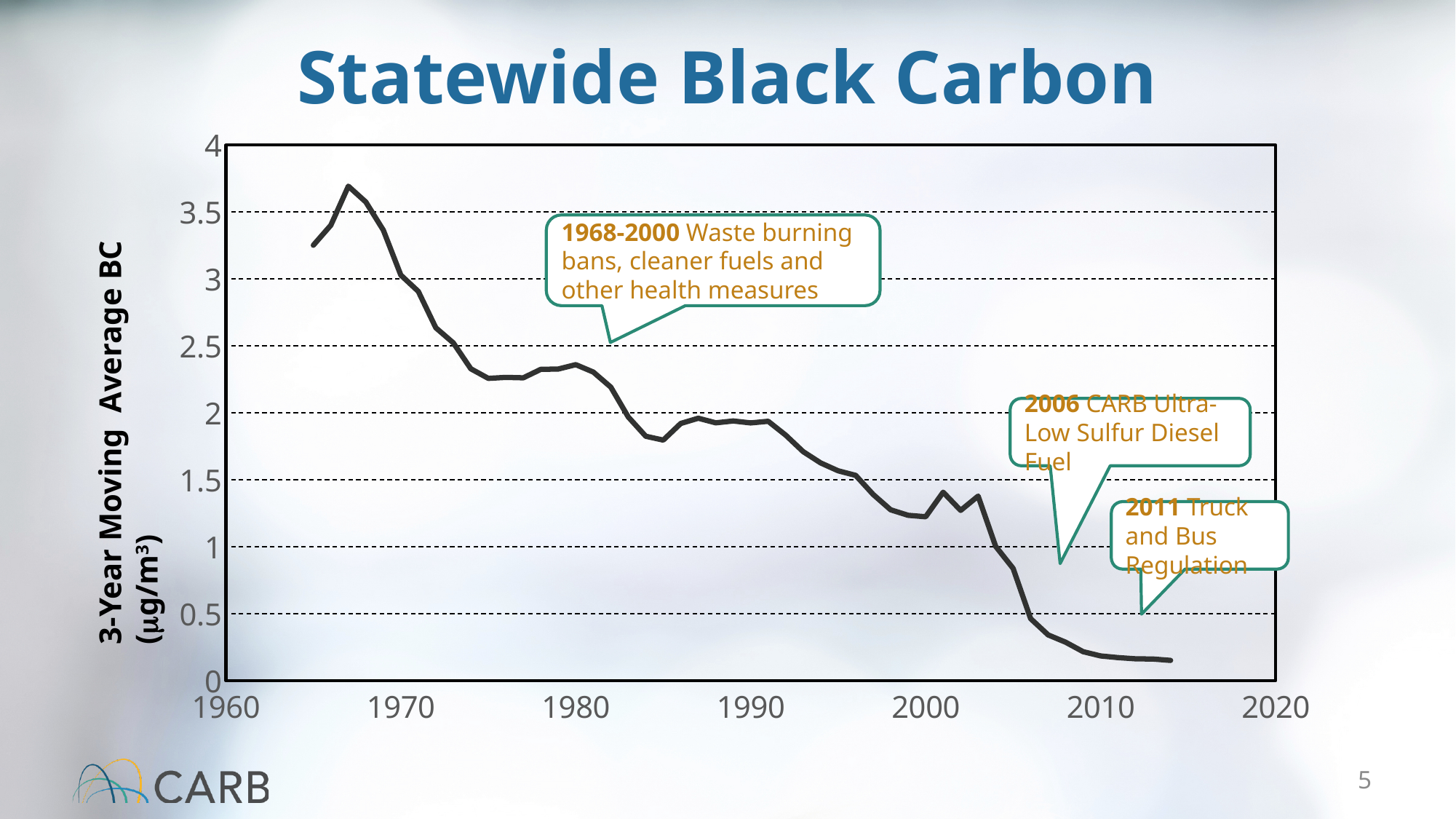
Is the value for 2000 greater or less than 1.5? less Is the value for 1980 greater or less than 2? greater Is the value for 1990 greater or less than 1.5? greater What kind of chart is shown on the slide? line chart Do the black carbon values generally rise or fall from 1970 to 2014 along the x axis? fall How many data series are plotted on the chart? 1 What regulation does the annotation for 2011 name? Truck and Bus Regulation What is the title of the chart on the slide? Statewide Black Carbon Which is larger, the value for 1980 or the value for 2000? 1980